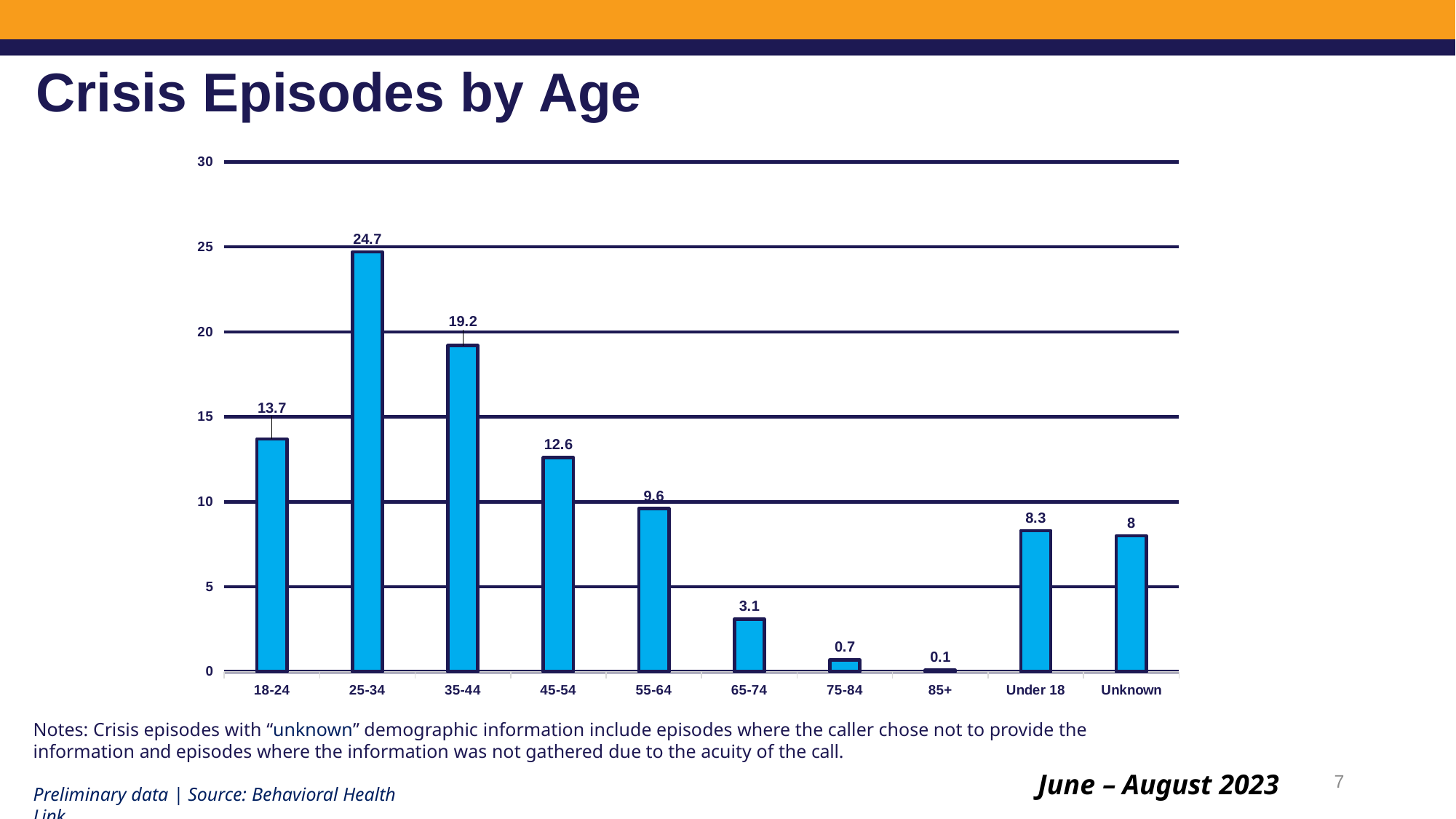
What is the value for the Unknown category? 8 Is the value for 55-64 greater or less than 10? less What is the value for the 25-34 age group? 24.7 Which is larger, the value for 18-24 or the value for 45-54? 18-24 Do the values rise or fall from 25-34 through 85+ along the x axis? fall What is the title of the slide? Crisis Episodes by Age What is the value for the Under 18 category? 8.3 How many age categories are shown on the x axis? 10 What kind of chart is shown on the slide? bar chart Which age category has the lowest value? 85+ Which age category has the highest value? 25-34 What is the difference between the values for 25-34 and 35-44? 5.5